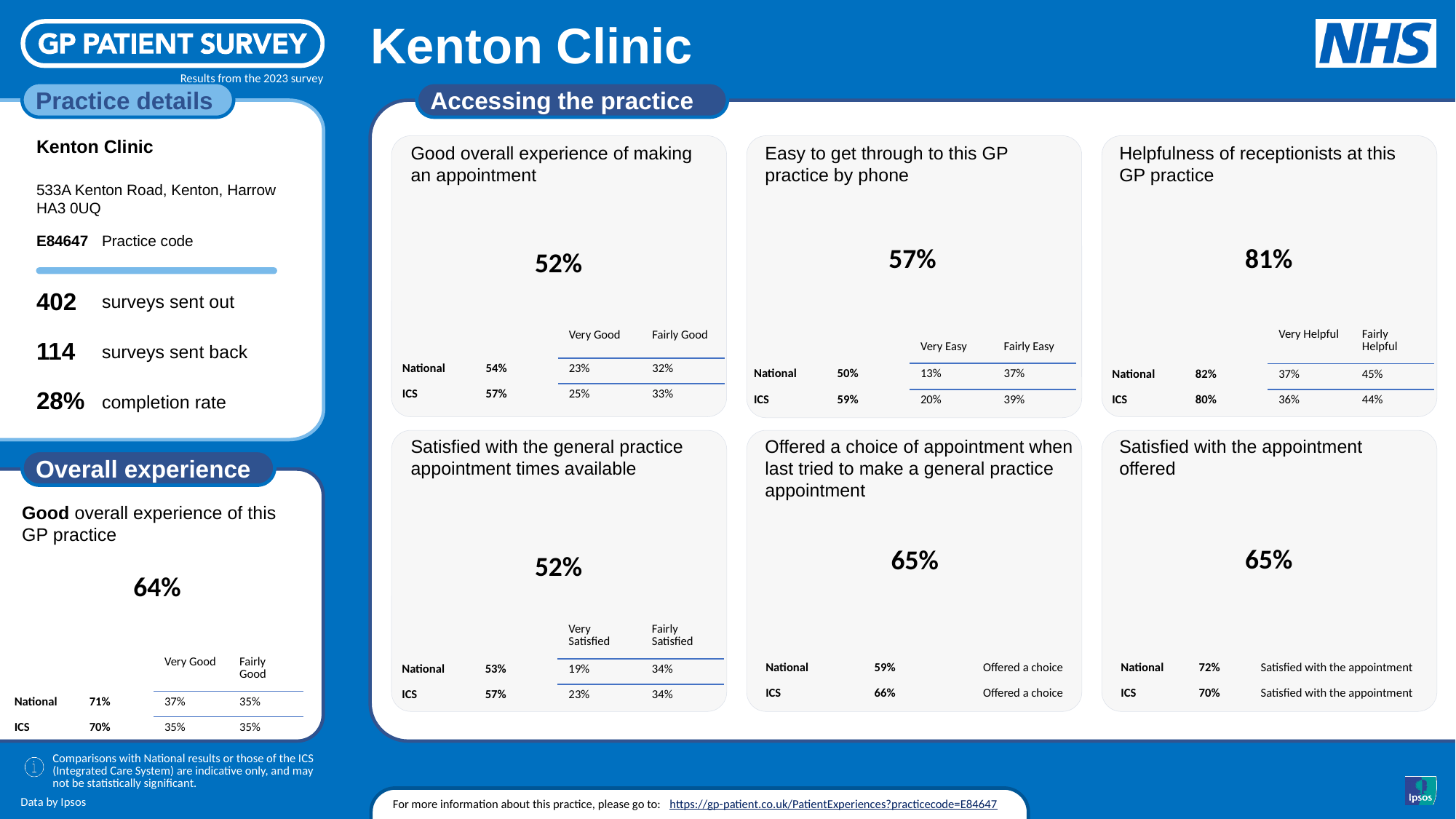
In the 'Offered a choice of appointment when last tried to make a general practice appointment' panel, what is the difference between the ICS value and the National value? 7% In the 'Good overall experience of making an appointment' panel, what is the practice's headline value? 52% In the 'Easy to get through to this GP practice by phone' panel, which is larger: the practice's headline value or the National value? the practice's headline value (57%) How many panels are shown under the 'Accessing the practice' heading? 6 In the 'Satisfied with the appointment offered' panel, what is the National value? 72% In the 'Easy to get through to this GP practice by phone' panel, what is the National value? 50% In the 'Helpfulness of receptionists at this GP practice' panel, what is the ICS value for Very Helpful? 36% Among the six panels under 'Accessing the practice', which has the highest headline value? Helpfulness of receptionists at this GP practice (81%) In the 'Good overall experience of this GP practice' panel, what are the two breakdown categories shown in the table? Very Good and Fairly Good In the 'Satisfied with the general practice appointment times available' panel, what is the National value for Fairly Satisfied? 34% In the 'Good overall experience of this GP practice' panel under Overall experience, what is the practice's headline value? 64% In the 'Helpfulness of receptionists at this GP practice' panel, what is the difference between the National value and the practice's headline value? 1%